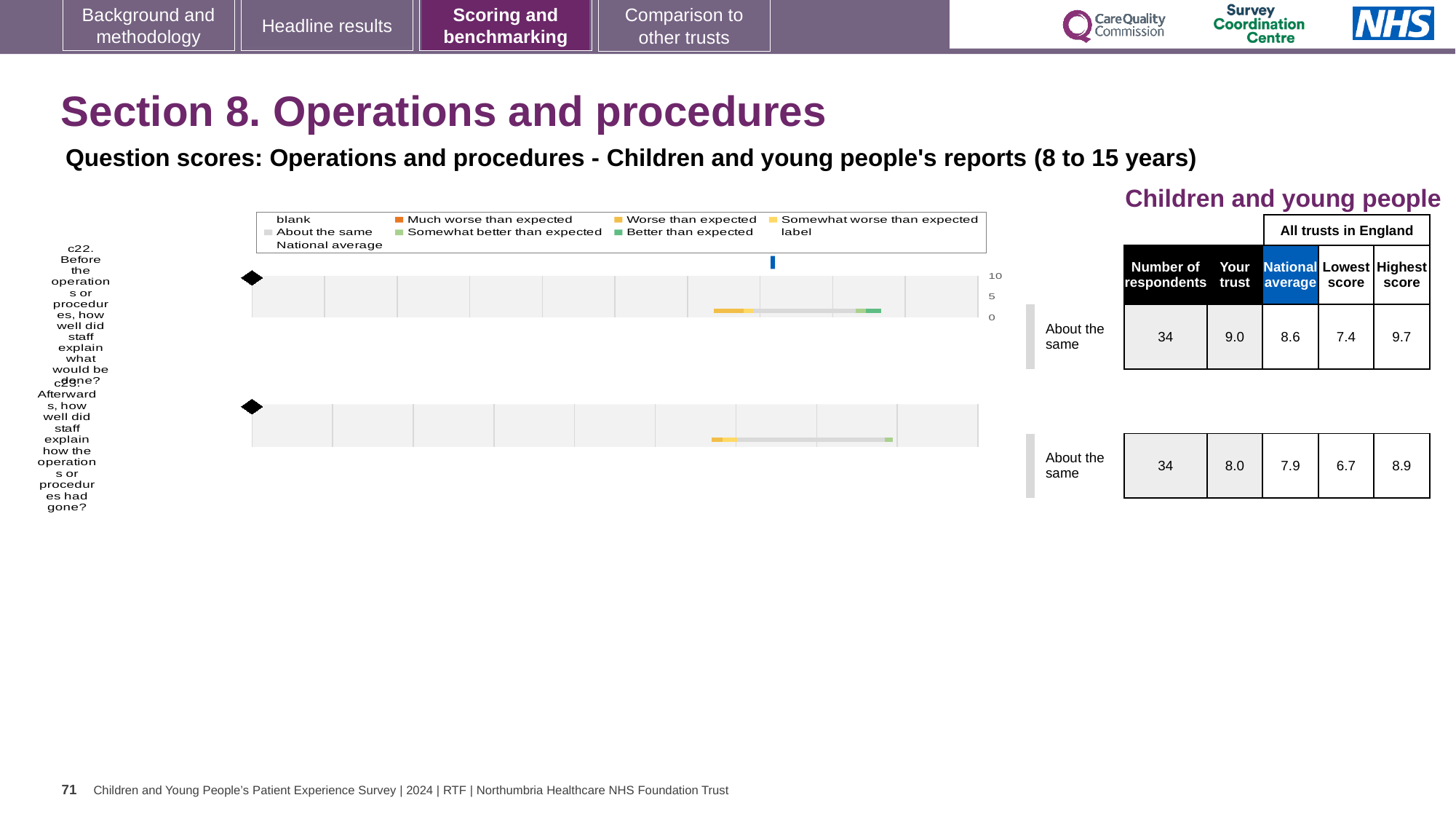
How many survey questions are plotted on the slide? 2 What is the difference between the highest score and the lowest score for c22? 2.3 How many respondents answered c22? 34 What is the 'Your trust' score for c22 (Before the operations or procedures, how well did staff explain what would be done?)? 9.0 What kind of chart is used to show the question scores for c22 and c23? bar chart What is the lowest score across all trusts in England for c23? 6.7 What is the national average score for c23 (Afterwards, how well did staff explain how the operations or procedures had gone?)? 7.9 What benchmark category is shown for c23? About the same What is the difference between the 'Your trust' score and the national average for c23? 0.1 For c22, which is larger: the 'Your trust' score or the national average? Your trust Which question has the higher 'Your trust' score, c22 or c23? c22 What colour represents 'Much worse than expected' in the chart legend? orange